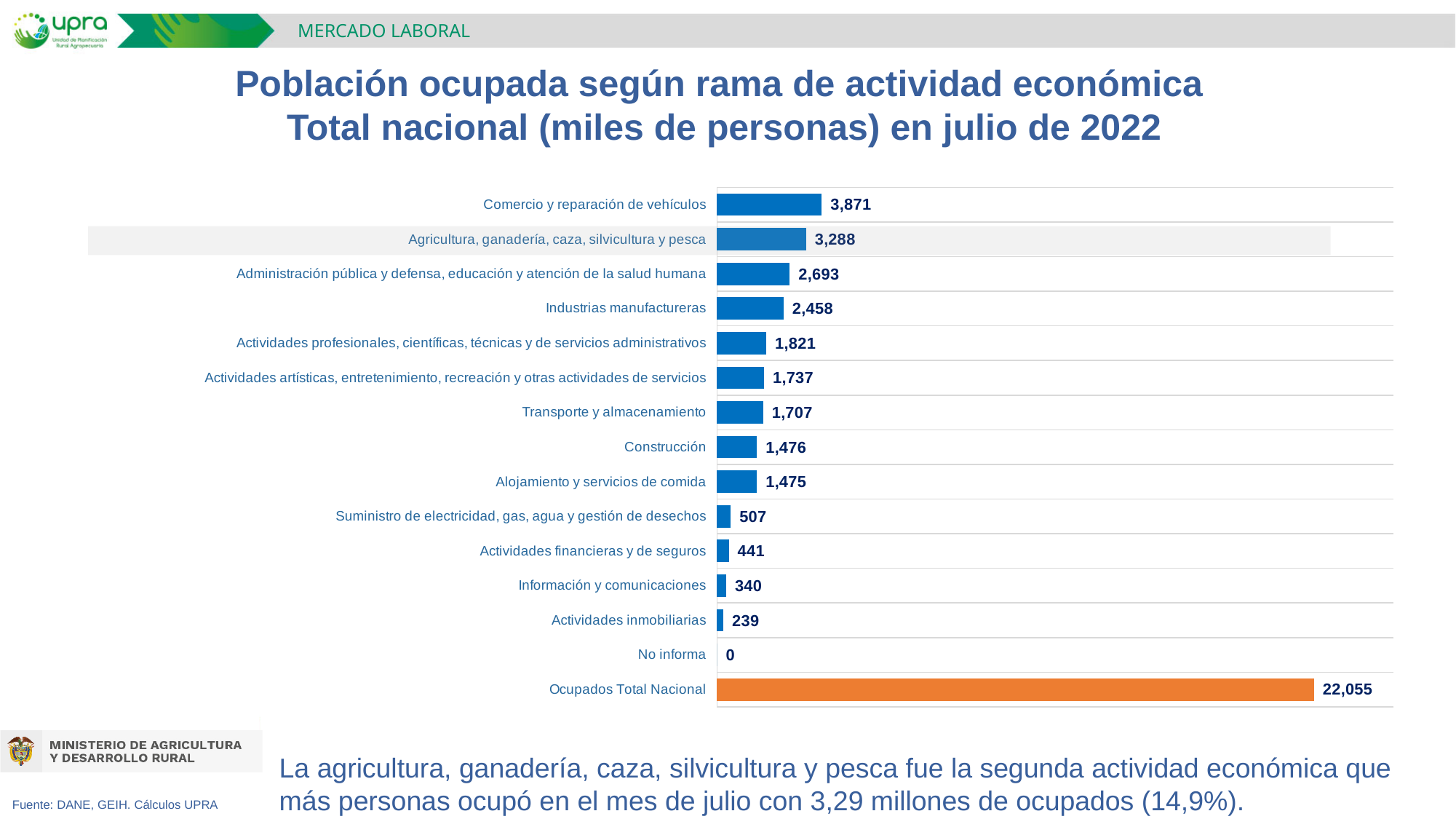
What is the value for Ocupados Total Nacional? 22,055 What is the value for Agricultura, ganadería, caza, silvicultura y pesca? 3,288 Which bar is shown in orange rather than blue? Ocupados Total Nacional Excluding the Ocupados Total Nacional bar, which category has the highest value? Comercio y reparación de vehículos What is the value for Comercio y reparación de vehículos? 3,871 What is the value for Actividades inmobiliarias? 239 How many categories are shown on the chart? 15 Which is larger, Industrias manufactureras or Transporte y almacenamiento? Industrias manufactureras What kind of chart is shown on the slide? Bar chart What is the difference between Comercio y reparación de vehículos and Agricultura, ganadería, caza, silvicultura y pesca? 583 Which category has the lowest value? No informa What is the difference between Suministro de electricidad, gas, agua y gestión de desechos and Actividades financieras y de seguros? 66